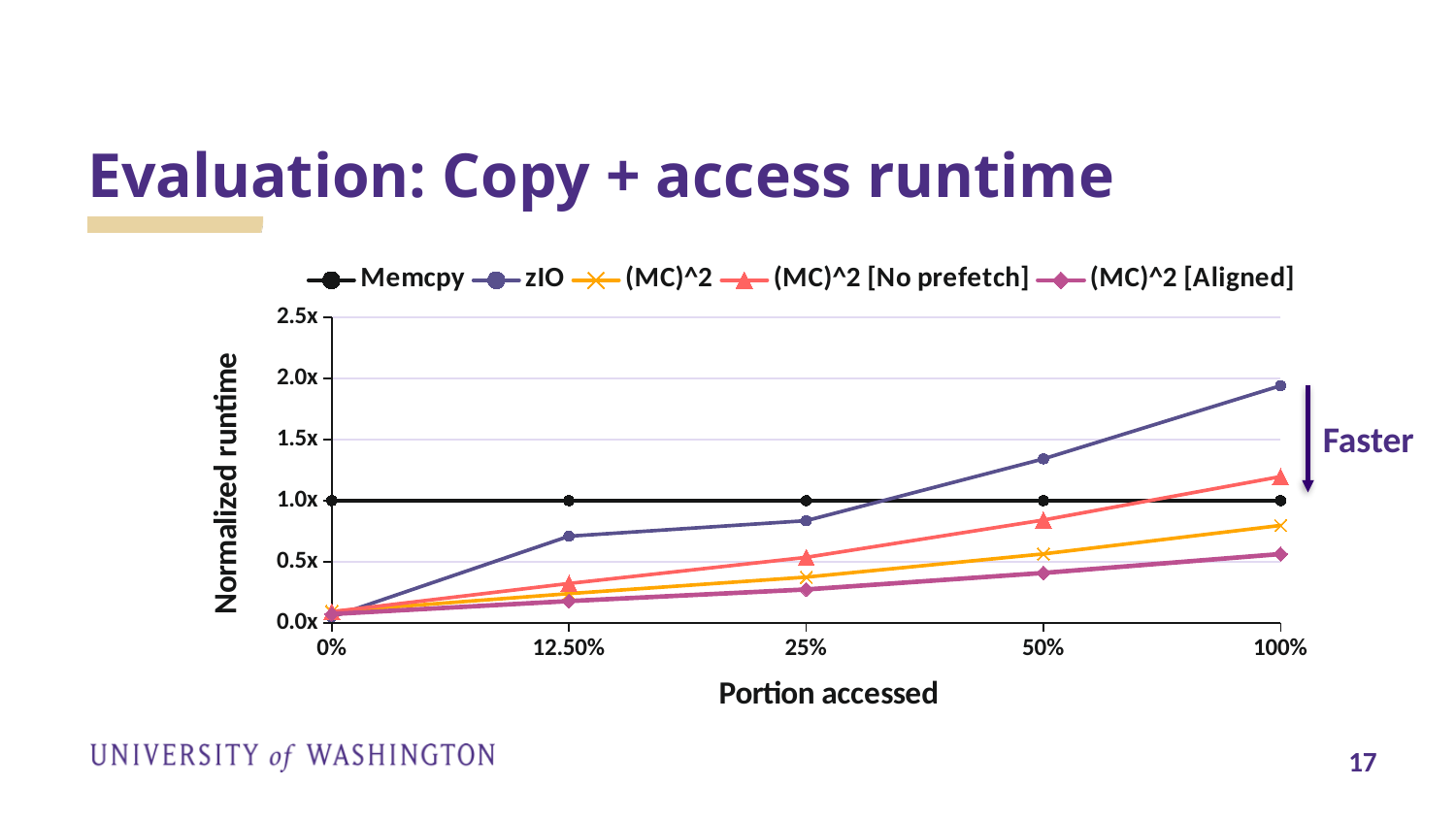
Is the normalized runtime for zIO at 100% portion accessed greater or less than 1.5x? greater Which series has the highest normalized runtime at 100% portion accessed? zIO Is the normalized runtime for (MC)^2 at 100% portion accessed greater or less than 1.0x? less Which series has the lowest normalized runtime at 100% portion accessed? (MC)^2 [Aligned] At 50% portion accessed, which has the larger normalized runtime: zIO or (MC)^2? zIO What is the normalized runtime for Memcpy at 50% portion accessed? 1.0x How many series does the legend list? 5 Does the normalized runtime for zIO rise or fall as the portion accessed increases? rise Is the normalized runtime for (MC)^2 [No prefetch] at 100% portion accessed greater or less than 1.0x? greater What is the label of the y axis? Normalized runtime What kind of chart is shown on the slide? line chart How many points are on the x axis (Portion accessed)? 5